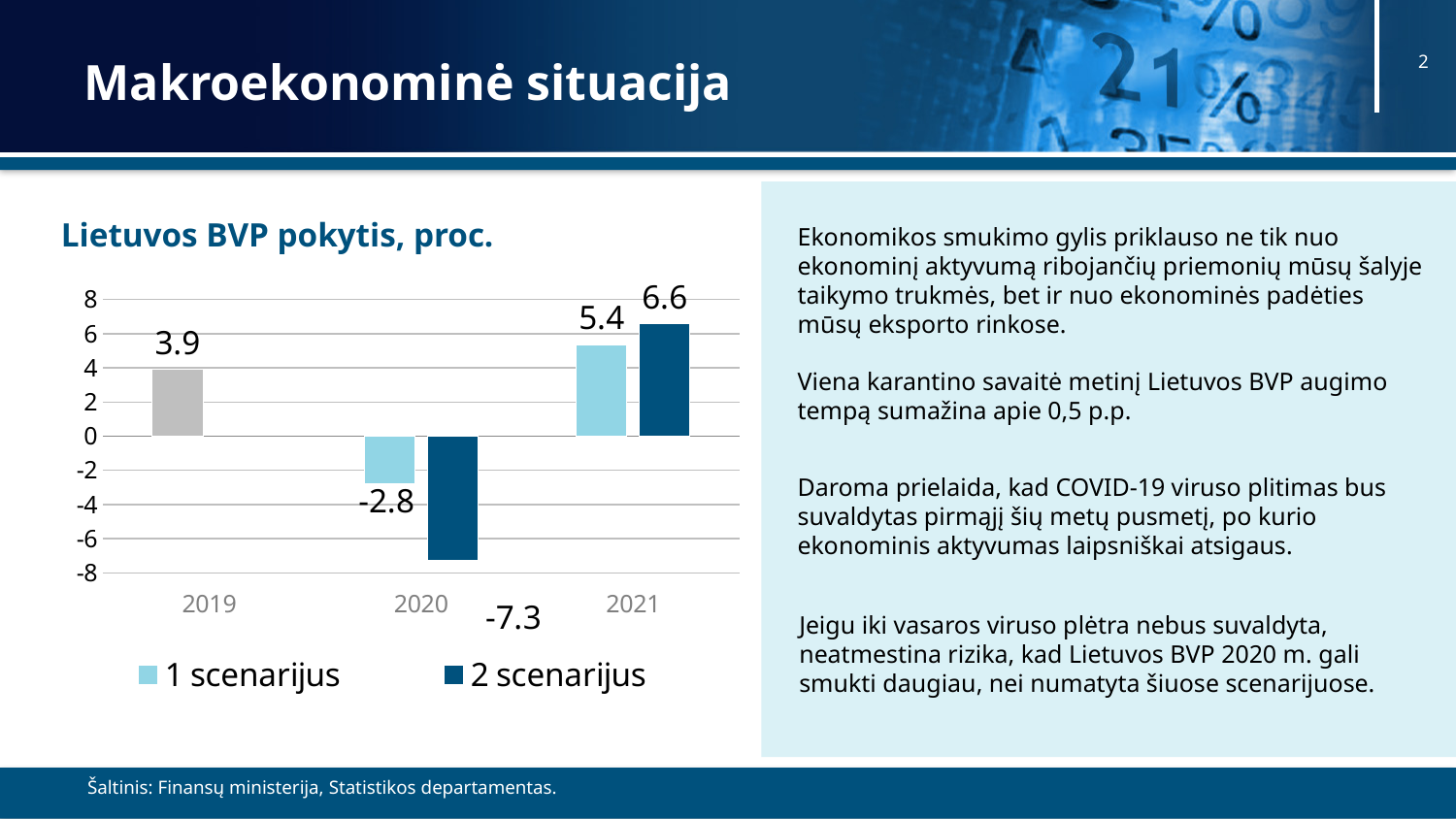
How many years are shown on the x axis of the chart? 3 Which year has the lowest value in the chart? 2020 What is the value for '2 scenarijus' in 2020? -7.3 Which is larger in 2021: '1 scenarijus' or '2 scenarijus'? 2 scenarijus What is the value for 2019 in the chart? 3.9 How many series does the legend list? 2 What type of chart is shown under the title 'Lietuvos BVP pokytis, proc.'? bar chart What is the value for '2 scenarijus' in 2021? 6.6 What is the value for '1 scenarijus' in 2020? -2.8 What is the value for '1 scenarijus' in 2021? 5.4 What is the difference between the '1 scenarijus' and '2 scenarijus' values in 2020? 4.5 What is the difference between the '2 scenarijus' and '1 scenarijus' values in 2021? 1.2